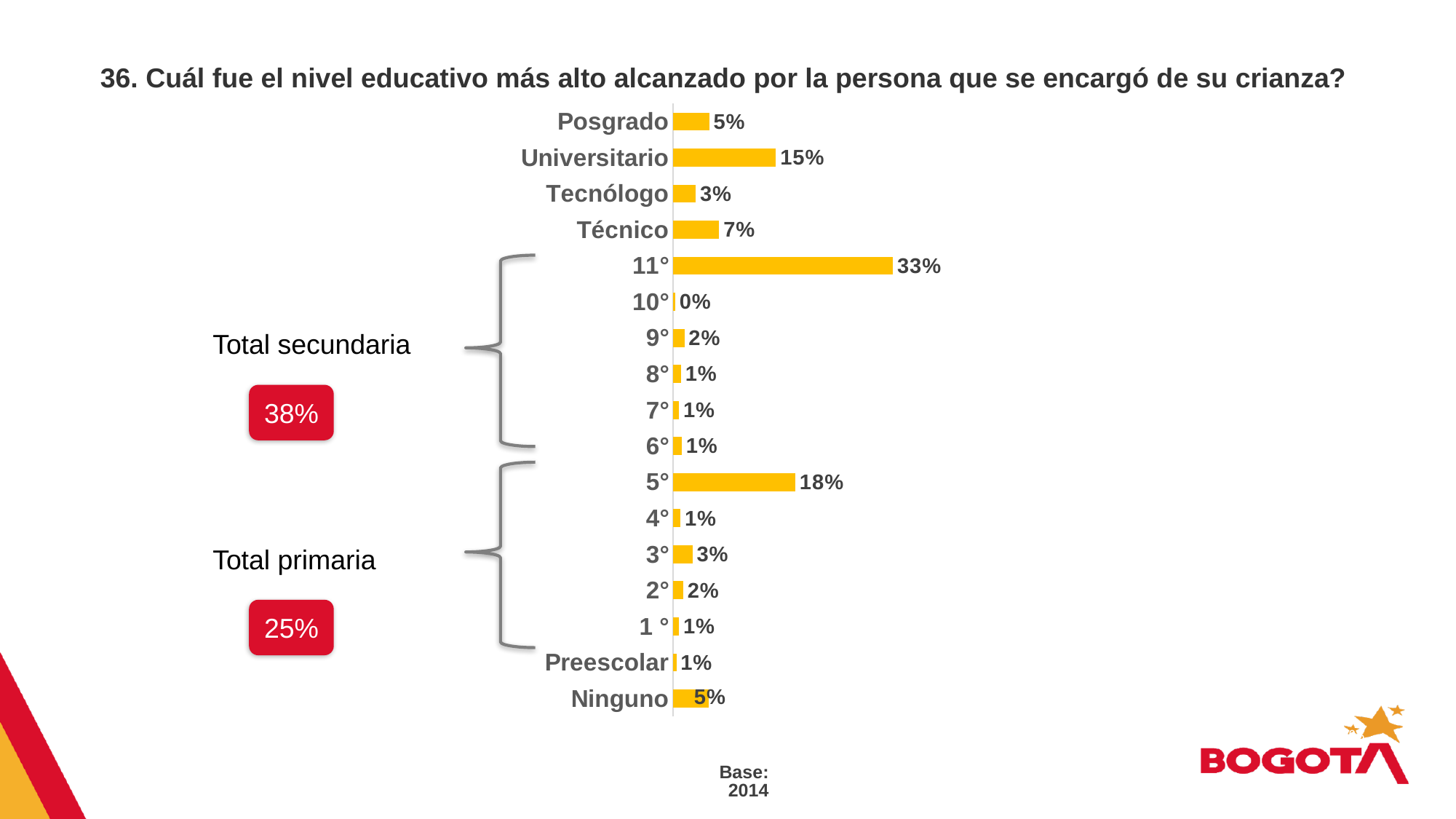
What is the value for Técnico? 7% Which category has the highest value? 11° Which category has the lowest value? 10° What is the difference between the values for 11° and 5°? 15% Which is larger, the value for Tecnólogo or the value for Técnico? Técnico What is the value for Universitario? 15% How many categories are shown in the chart? 17 What is the value for Ninguno? 5% What kind of chart is shown on the slide? Bar chart What is the difference between the values for Universitario and Posgrado? 10% What percentage is shown for Total secundaria? 38% What is the value for 5°? 18%